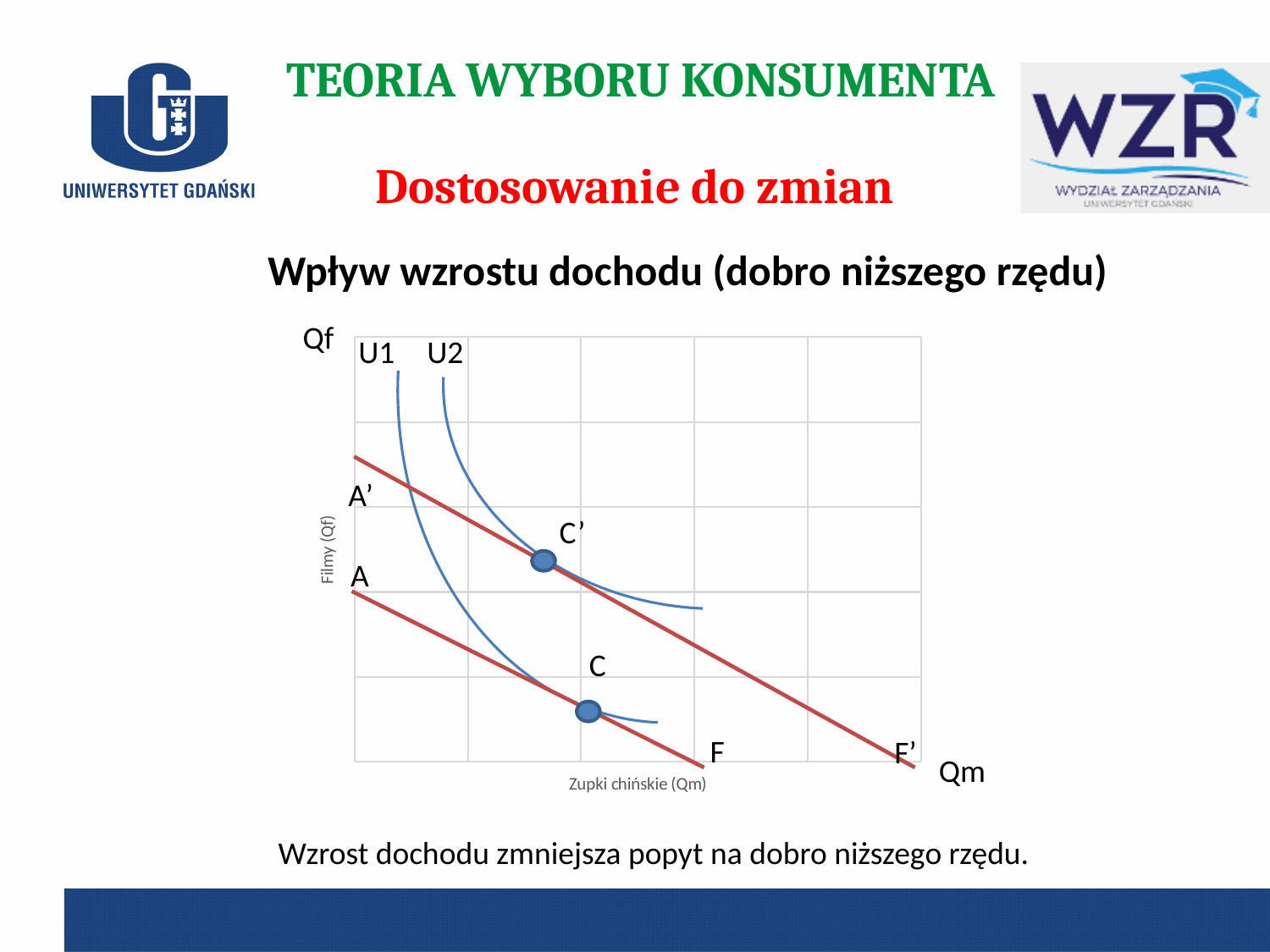
What is the label of the horizontal axis of the chart? Zupki chińskie (Qm) How many marked consumer equilibrium points are shown on the chart? 2 Which indifference curve does point C lie on, U1 or U2? U1 How many budget lines are drawn on the chart? 2 How many indifference curves (U curves) are drawn on the chart? 2 Which point lies further to the right on the Qm (Zupki chińskie) axis, C or C'? C What kind of chart is shown on the slide? line chart Which point lies higher on the Qf (Filmy) axis, C or C'? C' What is the label of the vertical axis of the chart? Filmy (Qf) Which indifference curve does point C' lie on, U1 or U2? U2 Which budget line intersects the vertical axis higher, AF or A'F'? A'F'